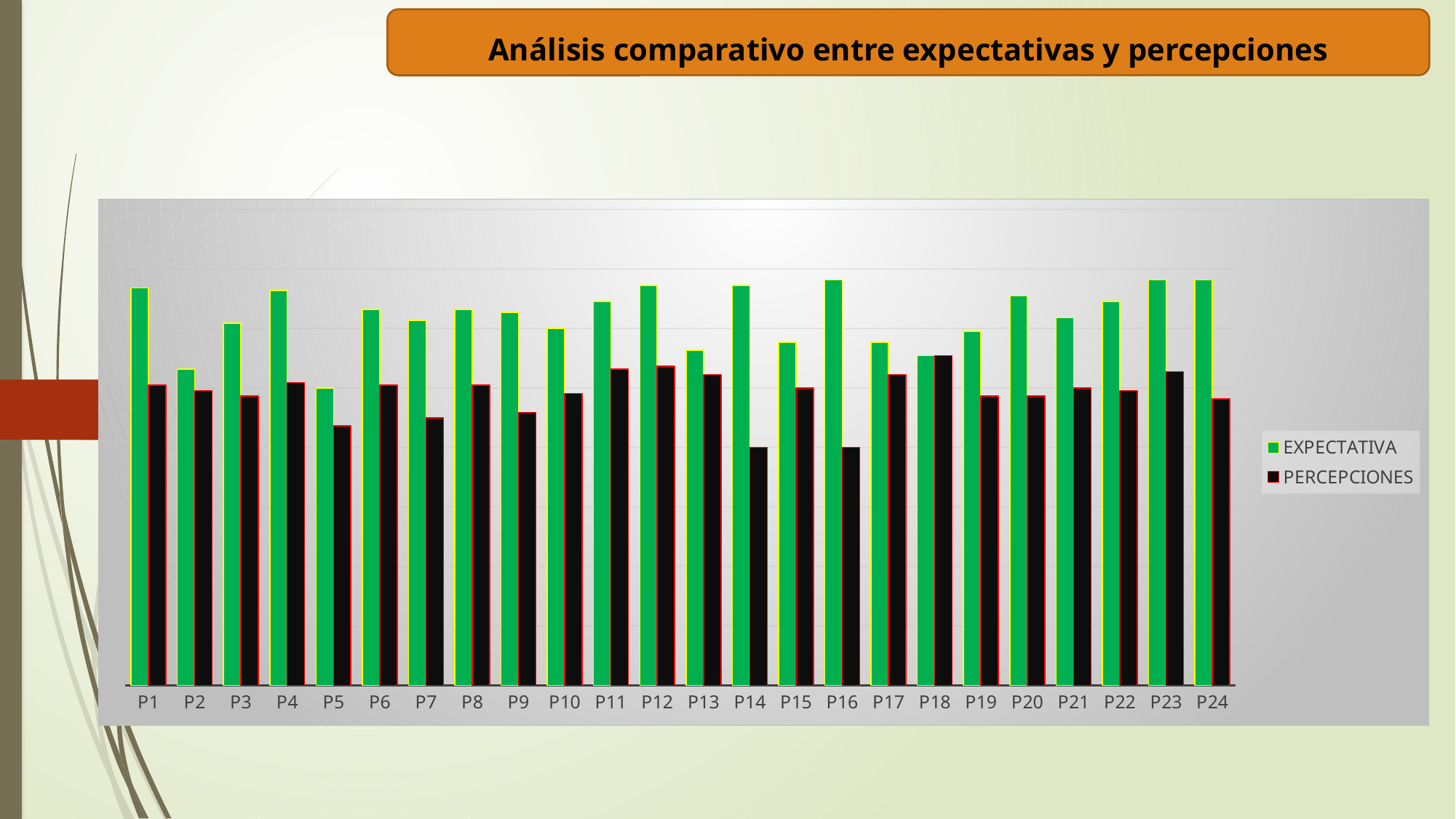
Which has the larger EXPECTATIVA value, P4 or P5? P4 For P1, which is larger, EXPECTATIVA or PERCEPCIONES? EXPECTATIVA What kind of chart is shown on the slide? bar chart Which has the larger EXPECTATIVA value, P13 or P14? P14 How many series does the chart's legend list? 2 How many categories are shown along the x axis of the chart? 24 Which category has the lowest EXPECTATIVA value? P5 Which series is drawn in green in the chart? EXPECTATIVA What are the two series named in the chart's legend? EXPECTATIVA and PERCEPCIONES